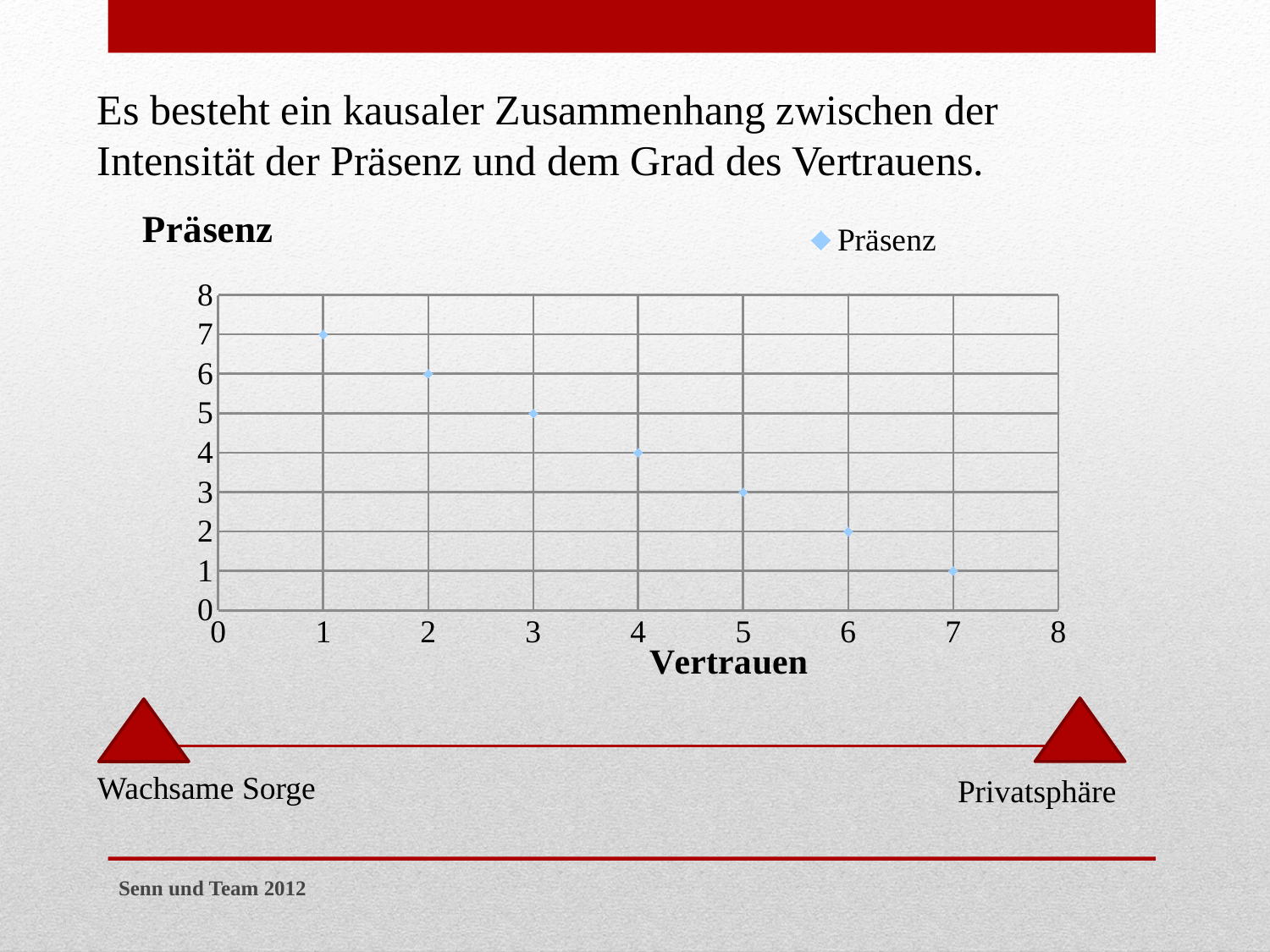
What is the Präsenz value at Vertrauen = 7? 1 How many data points are plotted in the chart? 7 What kind of chart is shown on the slide? scatter chart Do the Präsenz values rise or fall as Vertrauen increases along the x axis? fall Which is larger: the Präsenz value at Vertrauen = 3 or at Vertrauen = 5? Vertrauen = 3 What is the Präsenz value at Vertrauen = 1? 7 At which Vertrauen value is Präsenz lowest? 7 At which Vertrauen value is Präsenz highest? 1 What is the label of the x axis of the chart? Vertrauen What is the Präsenz value at Vertrauen = 4? 4 How many series does the legend list? 1 What is the difference between the Präsenz value at Vertrauen = 2 and at Vertrauen = 6? 4